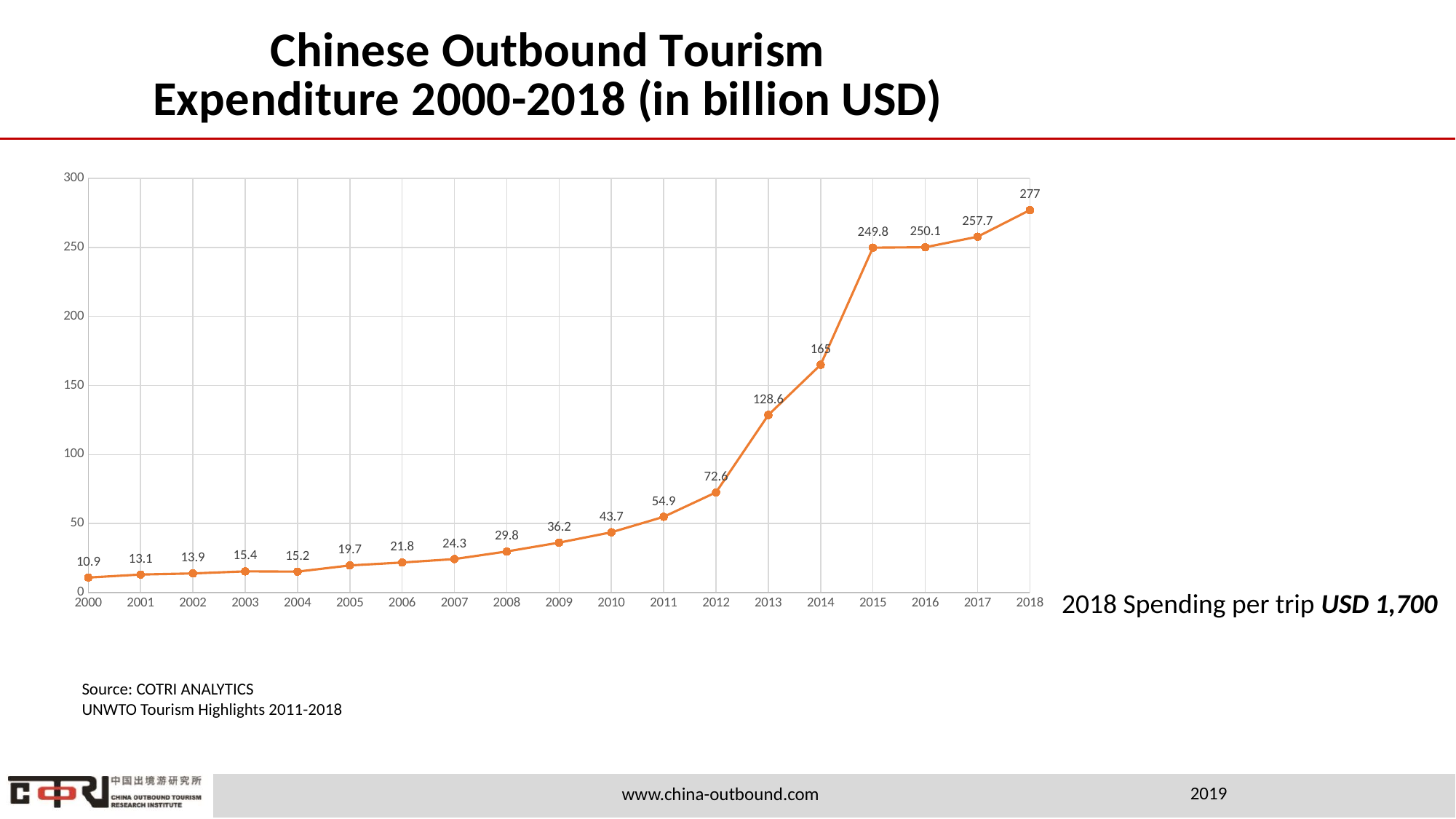
What value is shown for 2013? 128.6 What was the Chinese outbound tourism expenditure in 2018? 277 Is the value for 2012 greater or less than 100? less What was the Chinese outbound tourism expenditure in 2000? 10.9 Which is larger, the value for 2003 or the value for 2004? 2003 Which year has the highest expenditure? 2018 How many years are plotted on the chart? 19 What is the difference between the 2018 and 2017 values? 19.3 Does the expenditure generally rise or fall from 2000 to 2018? rise What kind of chart is shown on the slide? line chart Which year has the lowest expenditure? 2000 What is the difference between the 2015 and 2014 values? 84.8